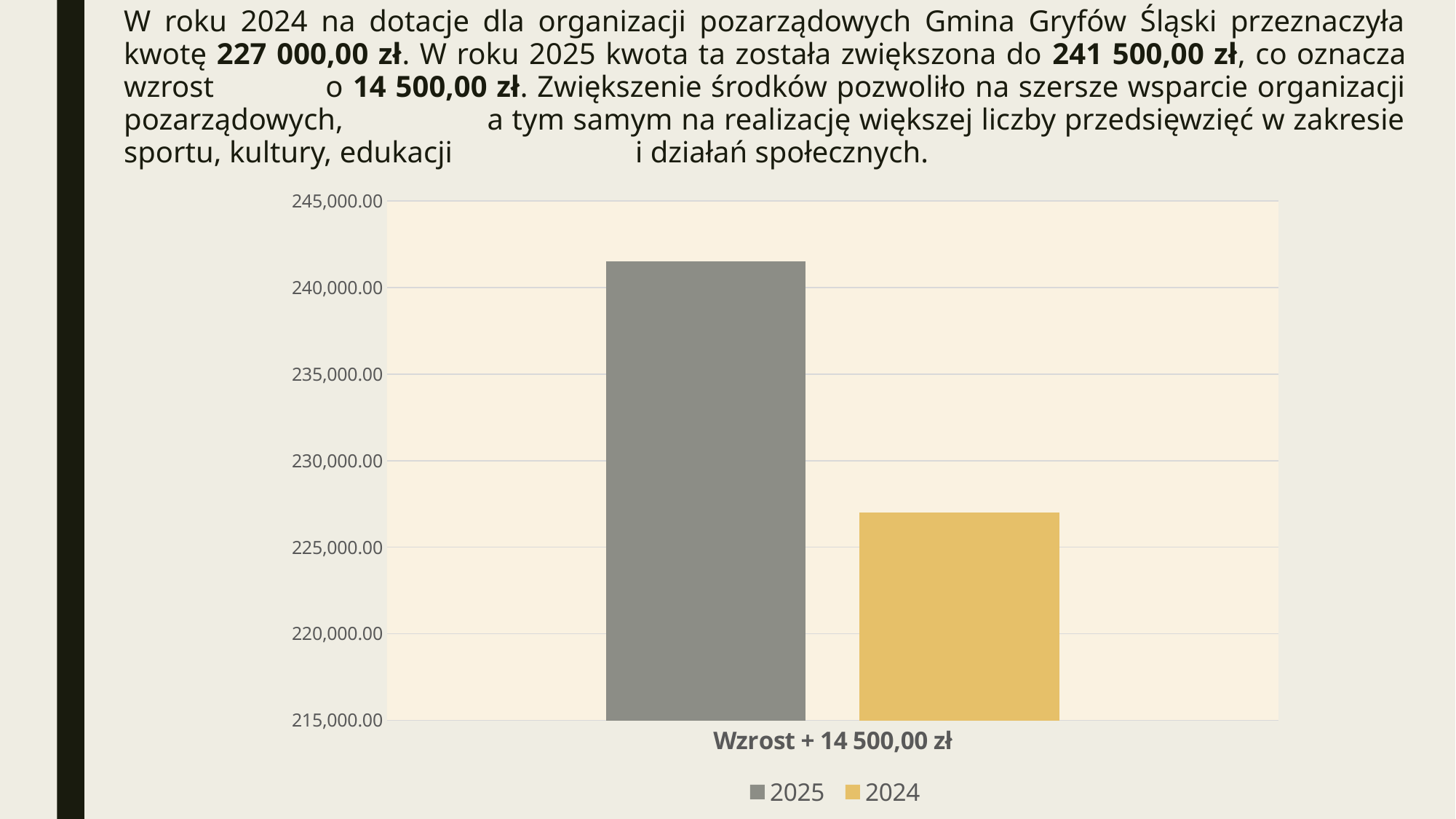
Which series has the taller bar, 2025 or 2024? 2025 Which series has the highest bar in the chart? 2025 Which series has the lowest bar in the chart? 2024 What is the category label shown under the bars on the x axis? Wzrost + 14 500,00 zł What kind of chart is shown on the slide? bar chart How many series does the chart legend list? 2 How many bars are plotted in the chart? 2 Is the value for 2025 greater or less than 240,000.00? greater Which colour is used for the 2024 series in the chart? yellow Is the value for 2024 greater or less than 225,000.00? greater Is the value for 2025 greater or less than 245,000.00? less